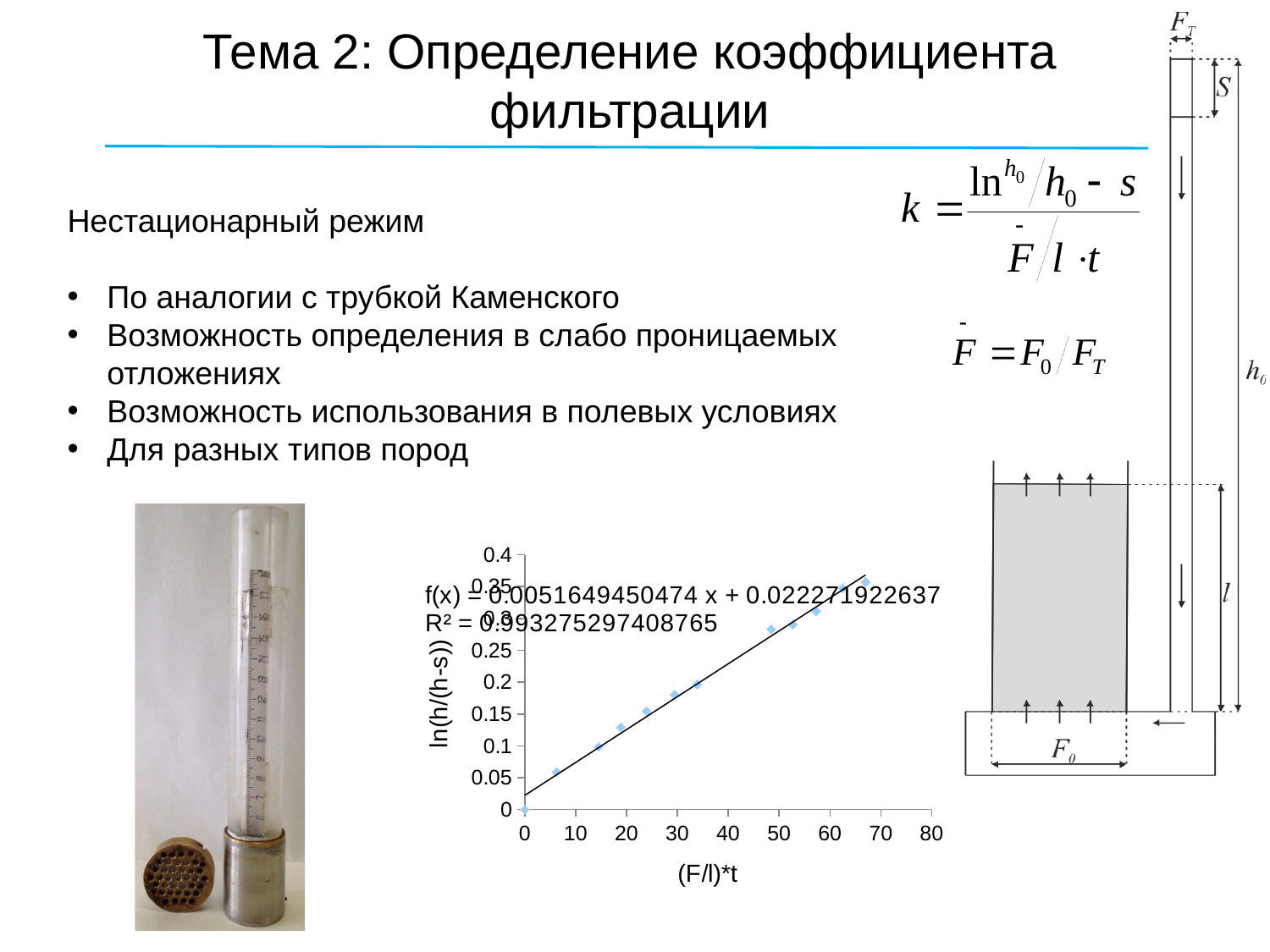
What is the highest tick value shown on the x axis? 80 Is the y value of the data point at x = 0 greater or less than 0.05? less What is the intercept of the trendline equation printed on the chart? 0.022271922637 What is the label of the y axis of the chart? ln(h/(h-s)) Is the y value of the rightmost data point greater or less than 0.3? greater What R² value is printed on the chart for the trendline? 0.993275297408765 What is the slope of the trendline equation printed on the chart? 0.0051649450474 What is the highest tick value shown on the y axis? 0.4 What is the label of the x axis of the chart? (F/l)*t Which data point has the higher y value: the one at x = 0 or the rightmost one? the rightmost one What kind of chart is shown on the slide? scatter chart Do the plotted values rise or fall as (F/l)*t increases? rise